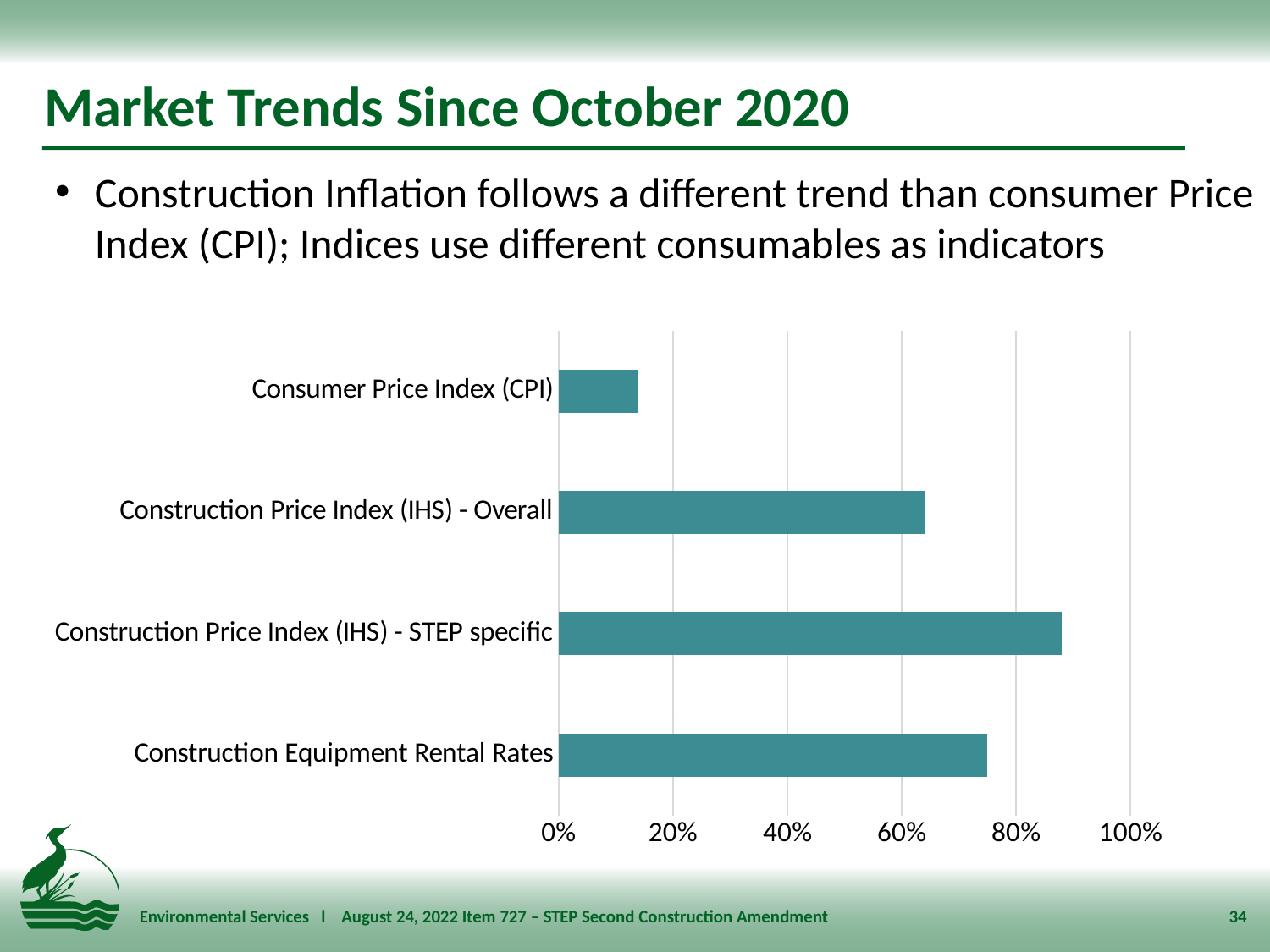
Is the value for Consumer Price Index (CPI) greater or less than 20%? less Which is larger, the value for Consumer Price Index (CPI) or the value for Construction Price Index (IHS) - STEP specific? Construction Price Index (IHS) - STEP specific How many categories are plotted in the chart? 4 Which is larger, the value for Construction Equipment Rental Rates or the value for Construction Price Index (IHS) - Overall? Construction Equipment Rental Rates Which category has the lowest value in the chart? Consumer Price Index (CPI) What kind of chart is shown on the slide? bar chart Which category has the highest value in the chart? Construction Price Index (IHS) - STEP specific What is the highest value shown on the x axis of the chart? 100% What is the title of the slide containing the chart? Market Trends Since October 2020 Is the value for Construction Price Index (IHS) - Overall greater or less than 60%? greater Is the value for Construction Equipment Rental Rates greater or less than 80%? less